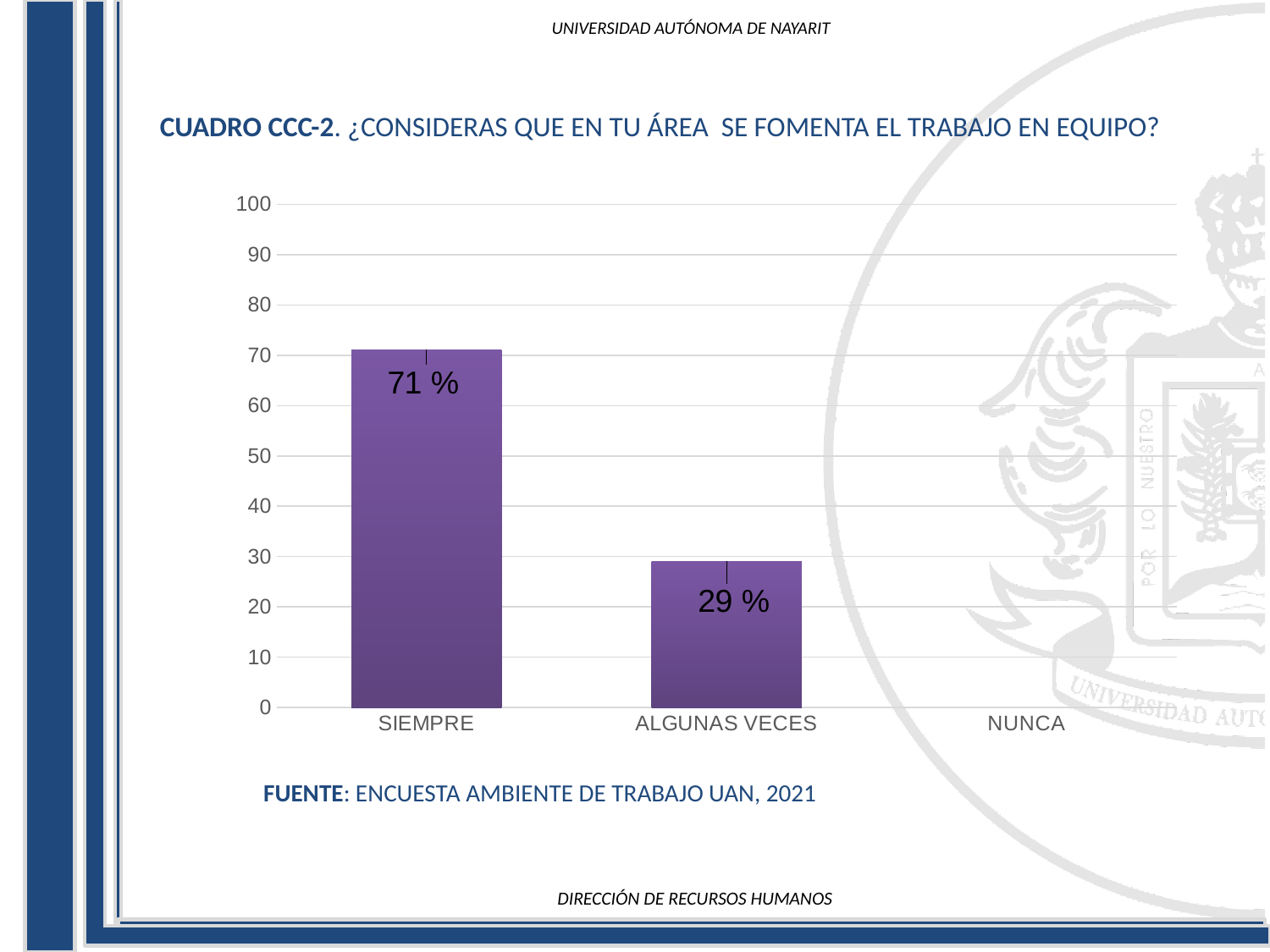
What kind of chart is shown on the slide? bar chart Which category has the highest value? SIEMPRE What is the difference between the values for SIEMPRE and ALGUNAS VECES? 42 % What is the value for SIEMPRE? 71 % Is the value for SIEMPRE greater or less than 60? greater Do the values rise or fall from left to right along the x axis? fall What is the value for ALGUNAS VECES? 29 % Is the value for ALGUNAS VECES greater or less than 40? less How many categories are shown on the x axis? 3 Which is larger, the value for SIEMPRE or the value for ALGUNAS VECES? SIEMPRE What is the source cited below the chart? ENCUESTA AMBIENTE DE TRABAJO UAN, 2021